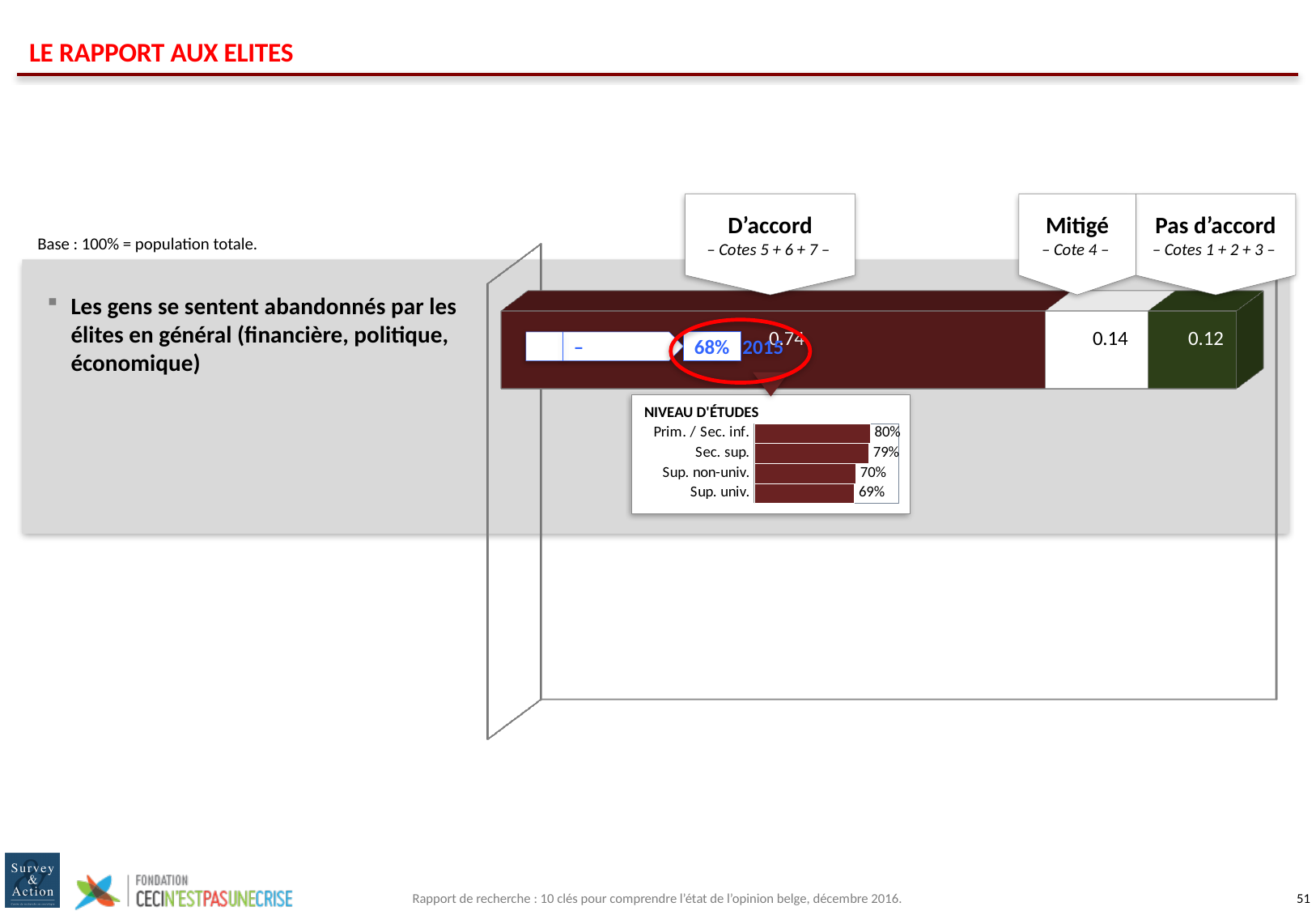
In the main stacked bar chart, what is the value for the 'D'accord' segment? 0.74 In the main stacked bar chart, what is the value for the 'Pas d'accord' segment? 0.12 In the 'NIVEAU D'ÉTUDES' chart, how many categories are shown? 4 In the main stacked bar chart, which segment is the smallest? Pas d'accord What kind of chart is the 'NIVEAU D'ÉTUDES' chart? Bar chart In the 'NIVEAU D'ÉTUDES' chart, what is the difference between 'Sec. sup.' and 'Sup. univ.'? 10% In the 'NIVEAU D'ÉTUDES' chart, what is the value for 'Prim. / Sec. inf.'? 80% In the main stacked bar chart, what is the difference between the 'D'accord' and 'Mitigé' values? 0.60 In the 'NIVEAU D'ÉTUDES' chart, which category has the lowest value? Sup. univ. In the main stacked bar chart, what is the value for the 'Mitigé' segment? 0.14 In the main stacked bar chart, which segment is the largest? D'accord In the 'NIVEAU D'ÉTUDES' chart, what is the value for 'Sup. non-univ.'? 70%